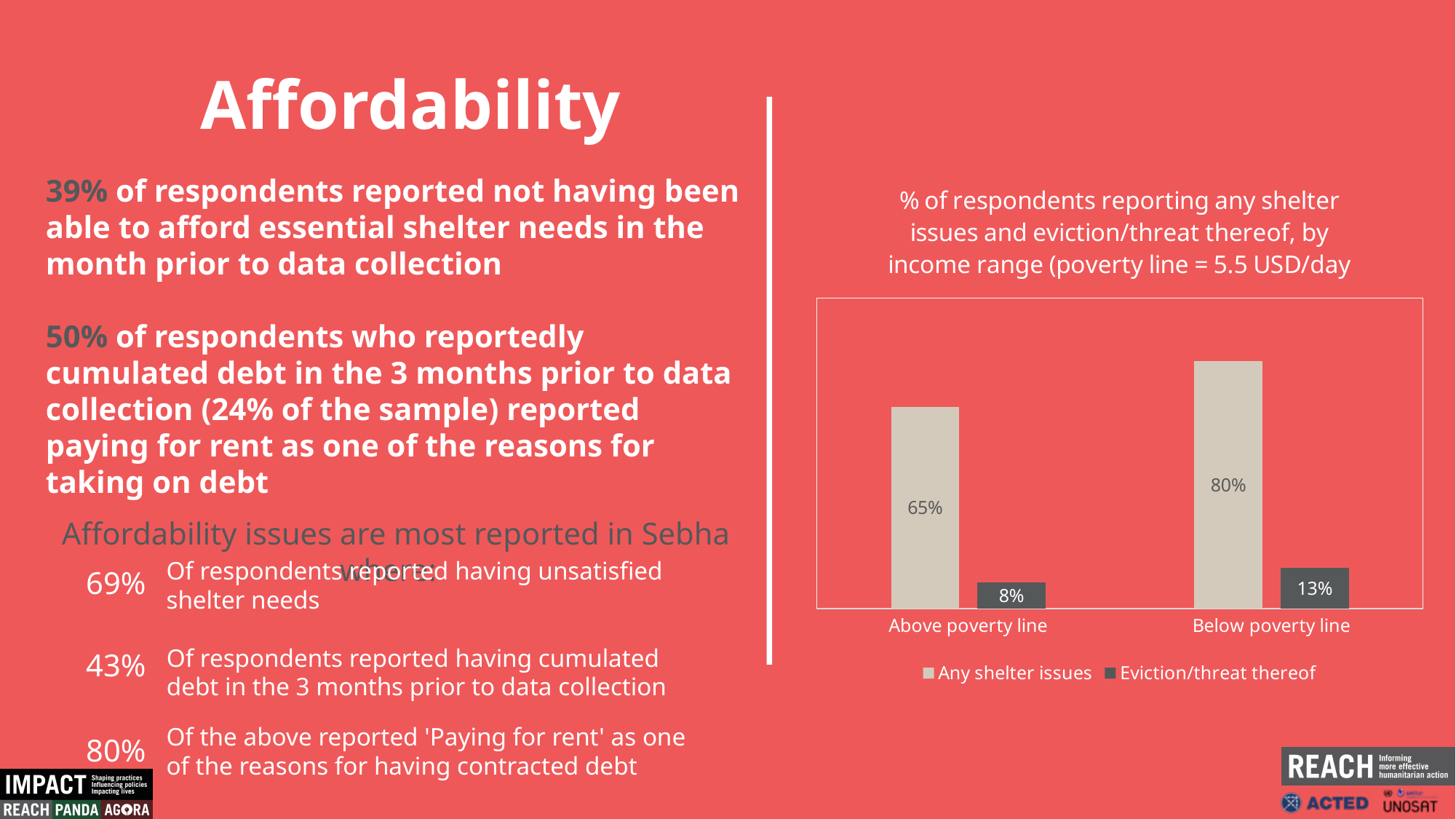
What percentage of respondents above the poverty line reported any shelter issues? 65% Which income category has the higher value for 'Any shelter issues'? Below poverty line What percentage of respondents below the poverty line reported eviction or threat thereof? 13% What is the value for 'Eviction/threat thereof' in the 'Above poverty line' category? 8% What is the difference between the 'Any shelter issues' values for below and above the poverty line? 15% Is the 'Eviction/threat thereof' value for 'Below poverty line' larger or smaller than the 'Any shelter issues' value for 'Above poverty line'? smaller Which income category has the lowest value for 'Eviction/threat thereof'? Above poverty line What is the difference between the 'Eviction/threat thereof' values for below and above the poverty line? 5% What type of chart is shown on the slide? bar chart How many income categories are shown on the x axis of the chart? 2 What is the value for 'Any shelter issues' in the 'Below poverty line' category? 80% How many series does the chart legend list? 2